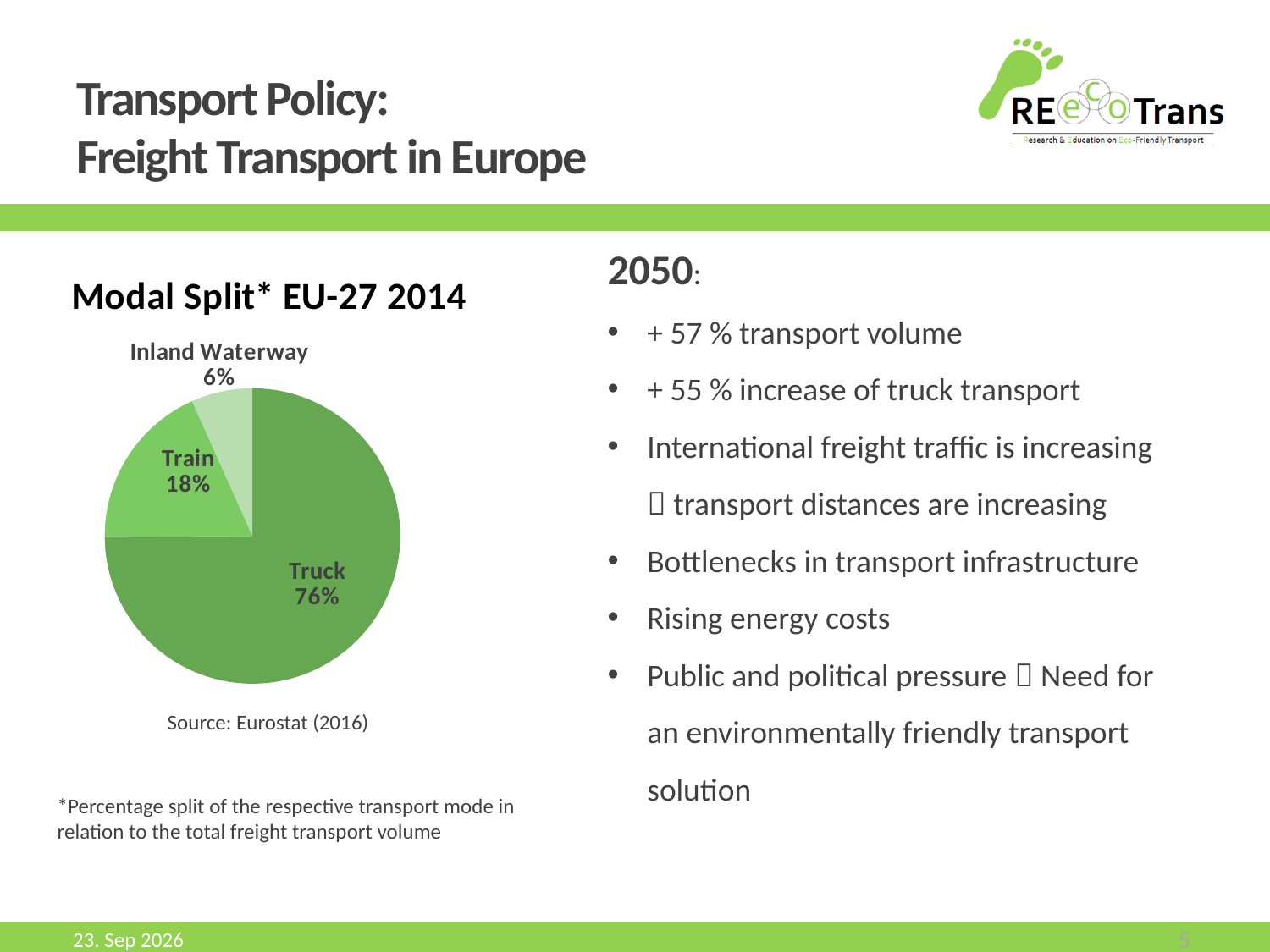
What source is cited below the chart? Eurostat (2016) What is the difference between the Truck share and the Train share? 58% What is the value shown for Inland Waterway? 6% What is the difference between the Train share and the Inland Waterway share? 12% What is the title of the chart? Modal Split* EU-27 2014 Which transport mode has the largest slice of the pie? Truck Which transport mode has the smallest slice of the pie? Inland Waterway What kind of chart is shown on the slide? pie chart What is the value shown for Train? 18% Which is larger, the share for Train or the share for Inland Waterway? Train What share of the pie does Truck have? 76% How many slices does the pie chart have? 3